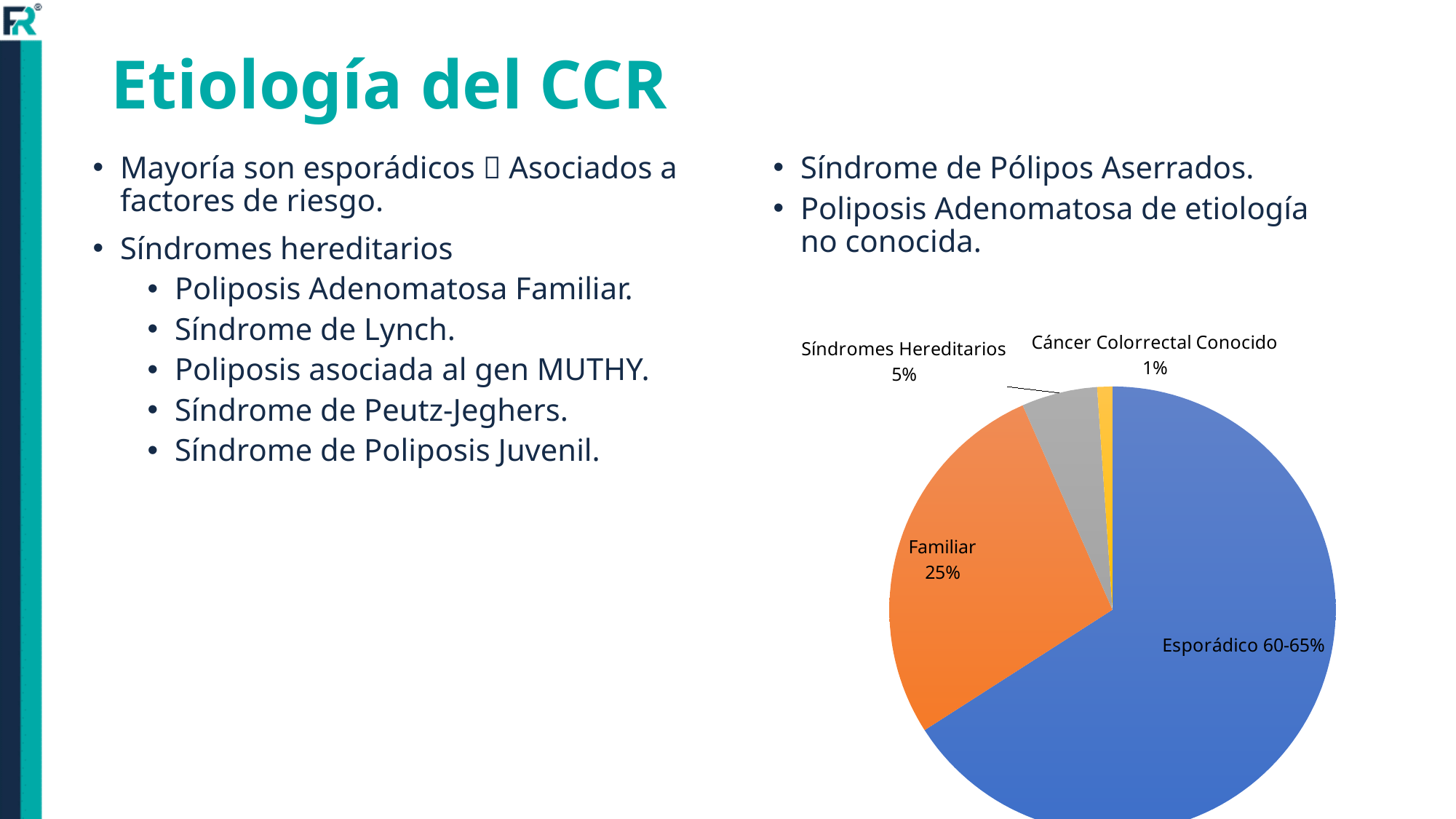
What colour is the Esporádico slice of the pie chart? Blue How many slices does the pie chart have? 4 What share of the pie is labelled for Cáncer Colorrectal Conocido? 1% What colour is the Familiar slice of the pie chart? Orange Which slice of the pie chart is the largest? Esporádico Which slice is larger, Familiar or Síndromes Hereditarios? Familiar What share of the pie is labelled for Síndromes Hereditarios? 5% What share of the pie is labelled for Familiar? 25% What is the difference between the Familiar share and the Síndromes Hereditarios share? 20% What value is printed on the Esporádico slice? 60-65% What kind of chart is shown on the slide? Pie chart Which slice of the pie chart is the smallest? Cáncer Colorrectal Conocido